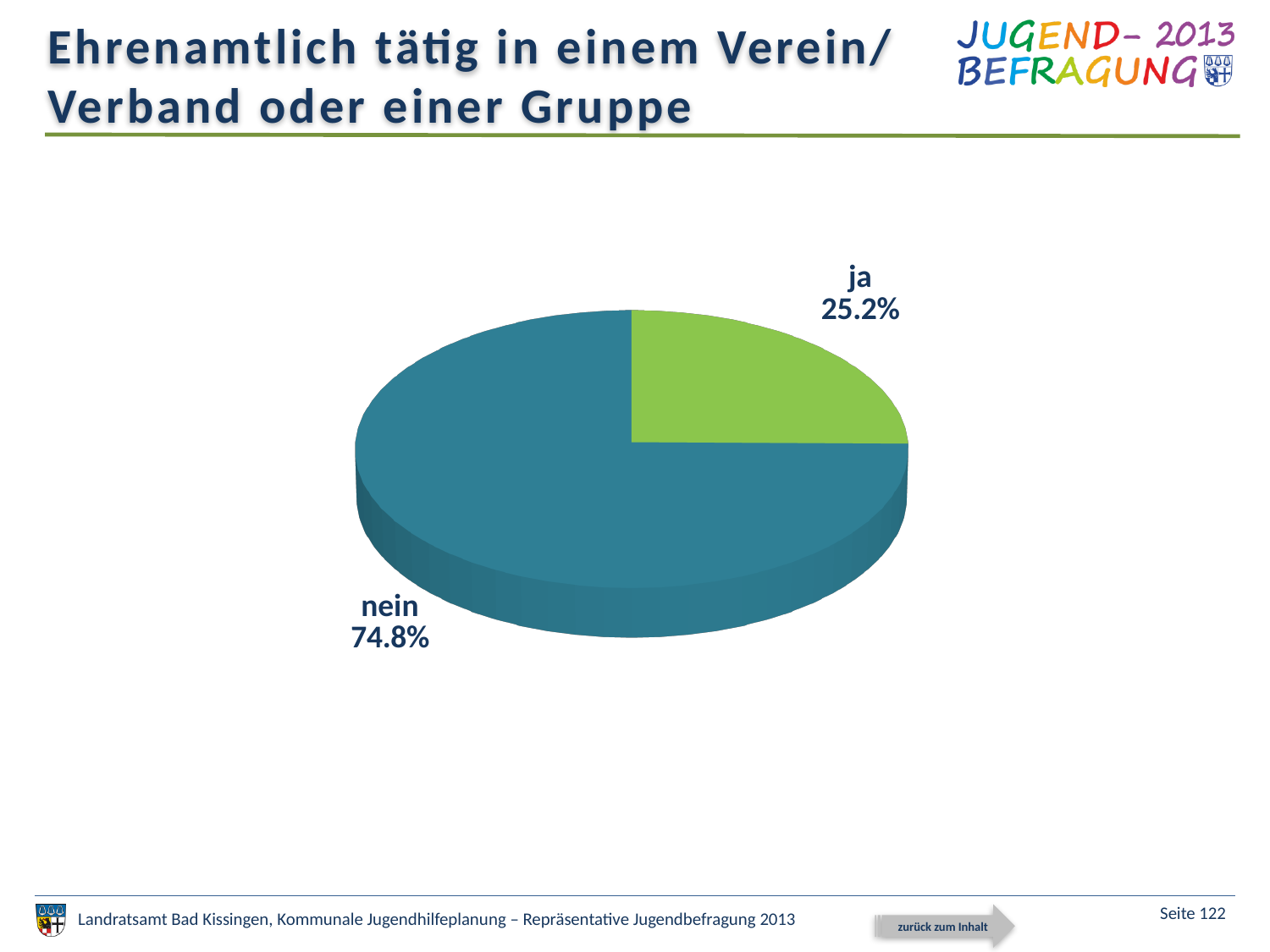
What share of the pie is labelled "nein"? 74.8% What is the combined share of the "ja" and "nein" slices? 100% What kind of chart is shown on the slide? pie chart What is the title of the slide containing the pie chart? Ehrenamtlich tätig in einem Verein/Verband oder einer Gruppe Which slice of the pie is the largest? nein What colour is the "ja" slice? green Which slice of the pie is the smallest? ja Which is larger, the "ja" slice or the "nein" slice? nein What is the difference in percentage points between the "nein" and "ja" slices? 49.6 How many slices does the pie chart have? 2 What share of the pie is labelled "ja"? 25.2%